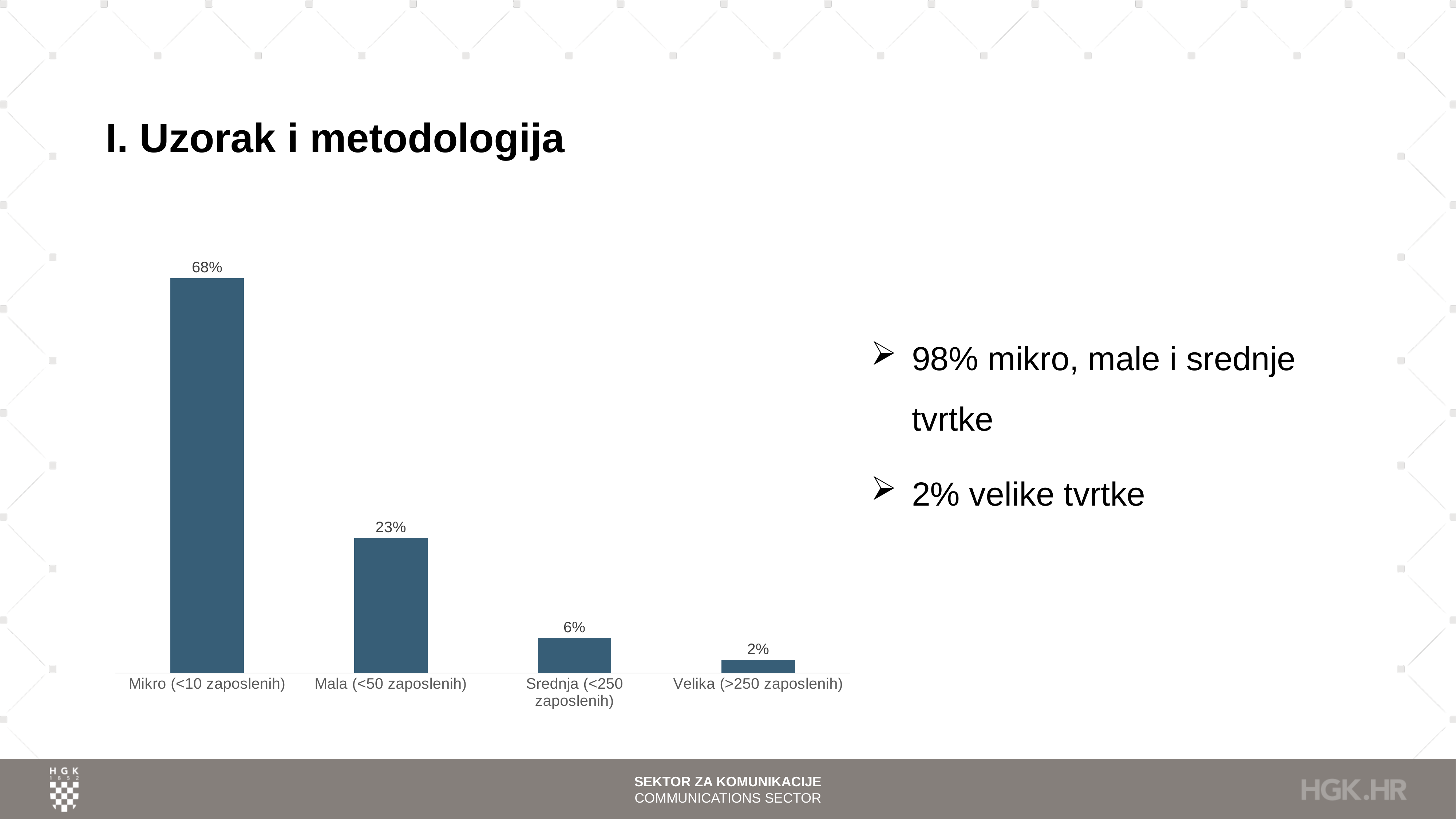
Which category has the lowest value? Velika (>250 zaposlenih) Which is larger, the value for Mala (<50 zaposlenih) or the value for Srednja (<250 zaposlenih)? Mala (<50 zaposlenih) Which category has the highest value? Mikro (<10 zaposlenih) What is the value for Mala (<50 zaposlenih)? 23% What is the value for Mikro (<10 zaposlenih)? 68% What is the value for Velika (>250 zaposlenih)? 2% How many categories are shown in the chart? 4 What is the value for Srednja (<250 zaposlenih)? 6% Do the values rise or fall from left to right along the x axis? Fall What kind of chart is shown on the slide? Bar chart What is the difference between the values for Mikro (<10 zaposlenih) and Mala (<50 zaposlenih)? 45% What is the difference between the values for Srednja (<250 zaposlenih) and Velika (>250 zaposlenih)? 4%